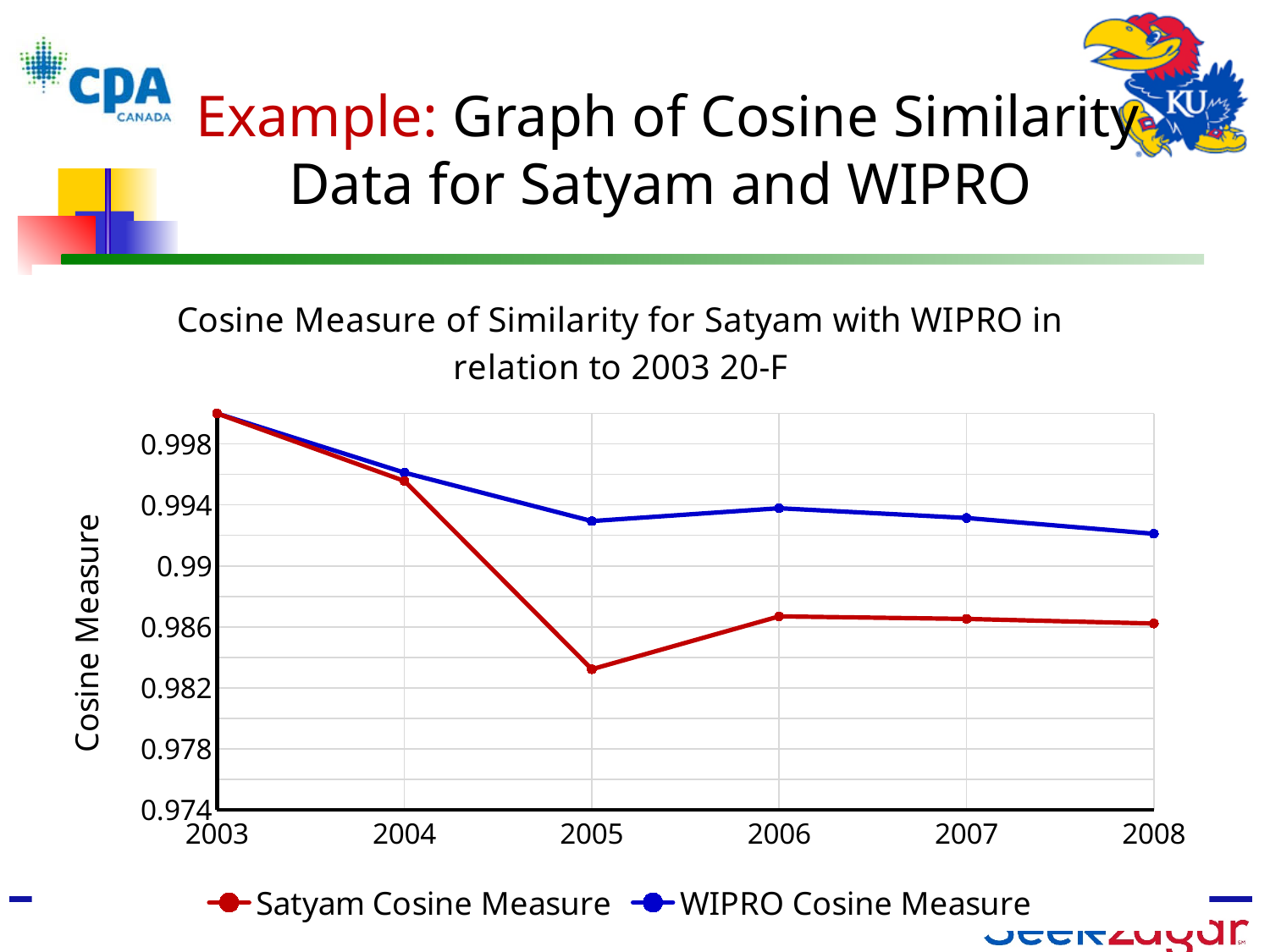
In which year is the WIPRO Cosine Measure lowest? 2008 What is the title of the chart? Cosine Measure of Similarity for Satyam with WIPRO in relation to 2003 20-F In which year is the Satyam Cosine Measure lowest? 2005 Does the Satyam Cosine Measure rise or fall from 2003 to 2005? fall Is the WIPRO Cosine Measure for 2005 greater or less than 0.99? greater How many series does the legend list? 2 Is the Satyam Cosine Measure for 2005 greater or less than 0.986? less What colour is the line for the WIPRO Cosine Measure? blue What kind of chart is shown on the slide? line chart How many years are plotted along the x axis? 6 Which series has the higher value in 2006, Satyam Cosine Measure or WIPRO Cosine Measure? WIPRO Cosine Measure Is the Satyam Cosine Measure for 2008 greater or less than 0.99? less